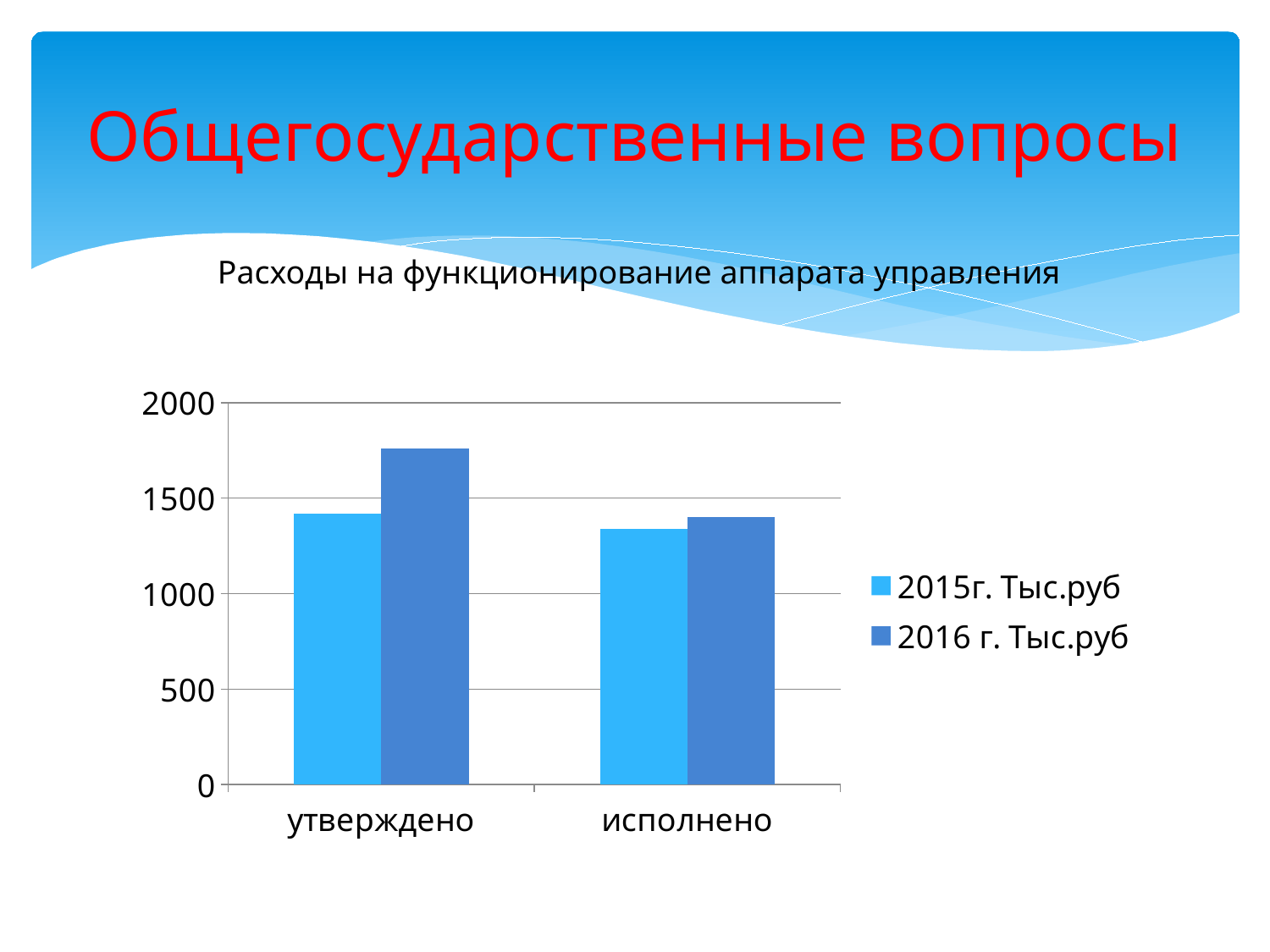
What is the subtitle describing the chart on the slide? Расходы на функционирование аппарата управления For утверждено, which series has the larger value, 2015г. Тыс.руб or 2016 г. Тыс.руб? 2016 г. Тыс.руб Is the value for исполнено in the 2015г. Тыс.руб series greater or less than 1500? less Is the value for утверждено in the 2016 г. Тыс.руб series greater or less than 1500? greater What kind of chart is shown on the slide? bar chart What are the two legend entries of the chart? 2015г. Тыс.руб and 2016 г. Тыс.руб Is the value for исполнено in the 2016 г. Тыс.руб series greater or less than 1000? greater How many categories are shown on the x axis? 2 In the 2016 г. Тыс.руб series, which category has the larger value, утверждено or исполнено? утверждено How many series does the legend list? 2 Which category and series has the highest bar in the chart? утверждено, 2016 г. Тыс.руб